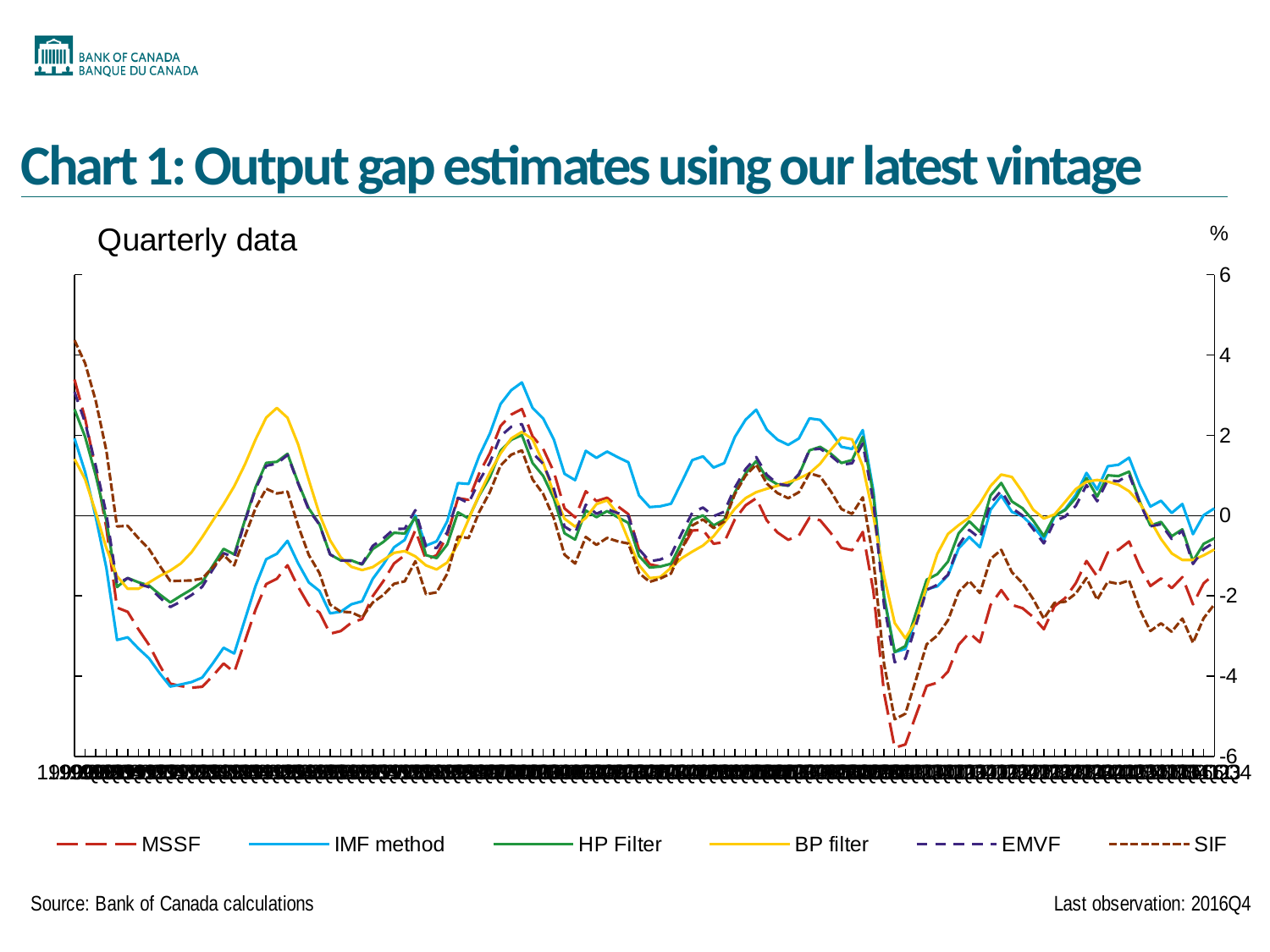
Is the lowest value reached by the BP filter line greater or less than -2? less How many series does the legend list? 6 Is the highest value reached by the IMF method line greater or less than 2? greater Is the lowest value reached by the MSSF line greater or less than -4? less Which series reaches a lower minimum, IMF method or BP filter? IMF method What is the last observation shown in the chart, according to the slide? 2016Q4 What kind of chart is shown on the slide? line chart What is the title of the chart? Chart 1: Output gap estimates using our latest vintage Which series reaches the highest value anywhere on the chart? SIF